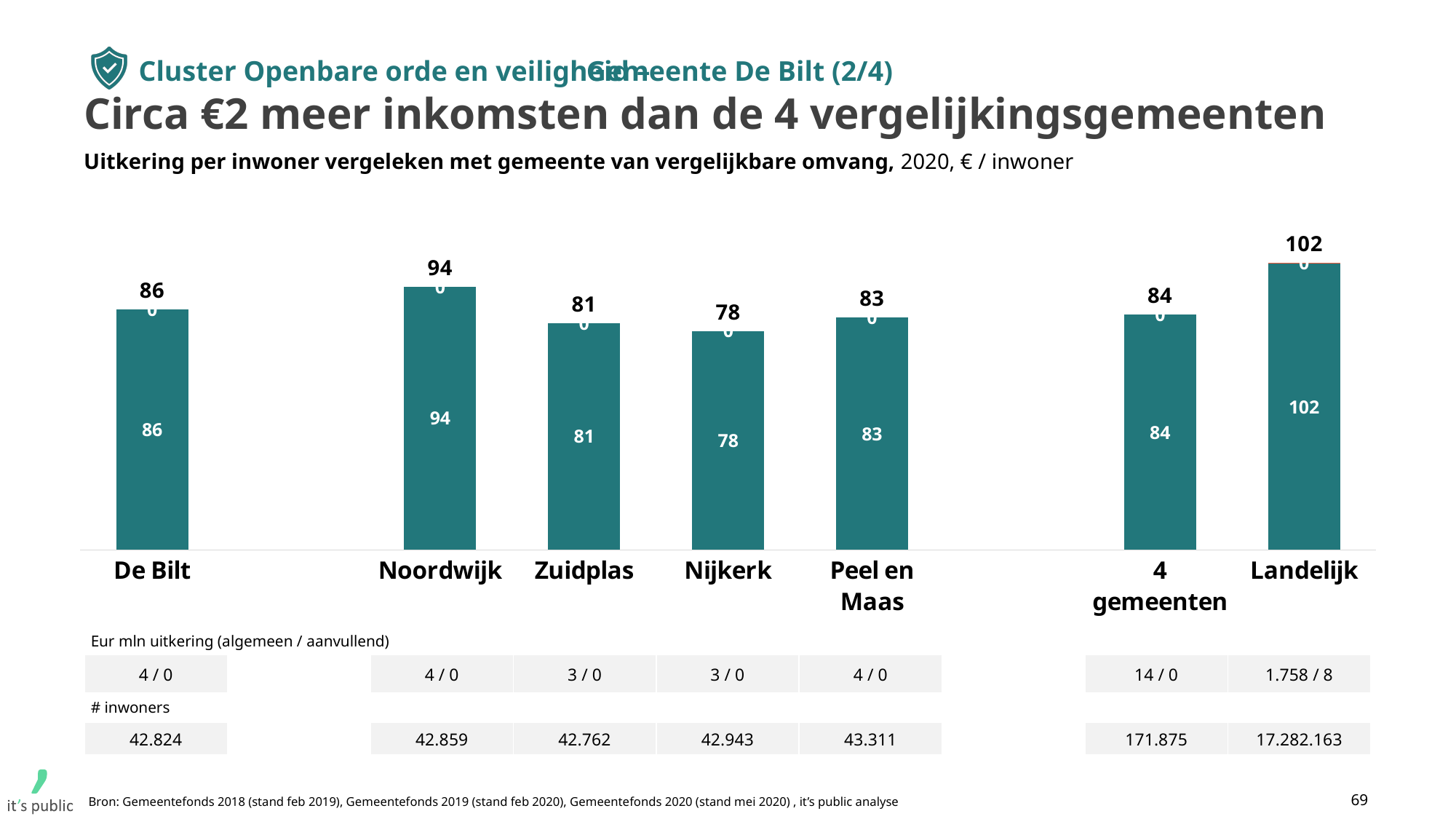
Which category has the lowest value? Nijkerk What is the value for Noordwijk? 94 What is the difference between the values for De Bilt and 4 gemeenten? 2 What is the difference between the values for Noordwijk and Nijkerk? 16 What is the value for De Bilt? 86 What is the value for Landelijk? 102 What kind of chart is shown on the slide? Bar chart Which category has the highest value? Landelijk How many bars are shown in the chart? 7 What unit is stated in the chart subtitle for the values? € / inwoner What is the value for 4 gemeenten? 84 Which is larger, the value for Zuidplas or the value for Peel en Maas? Peel en Maas